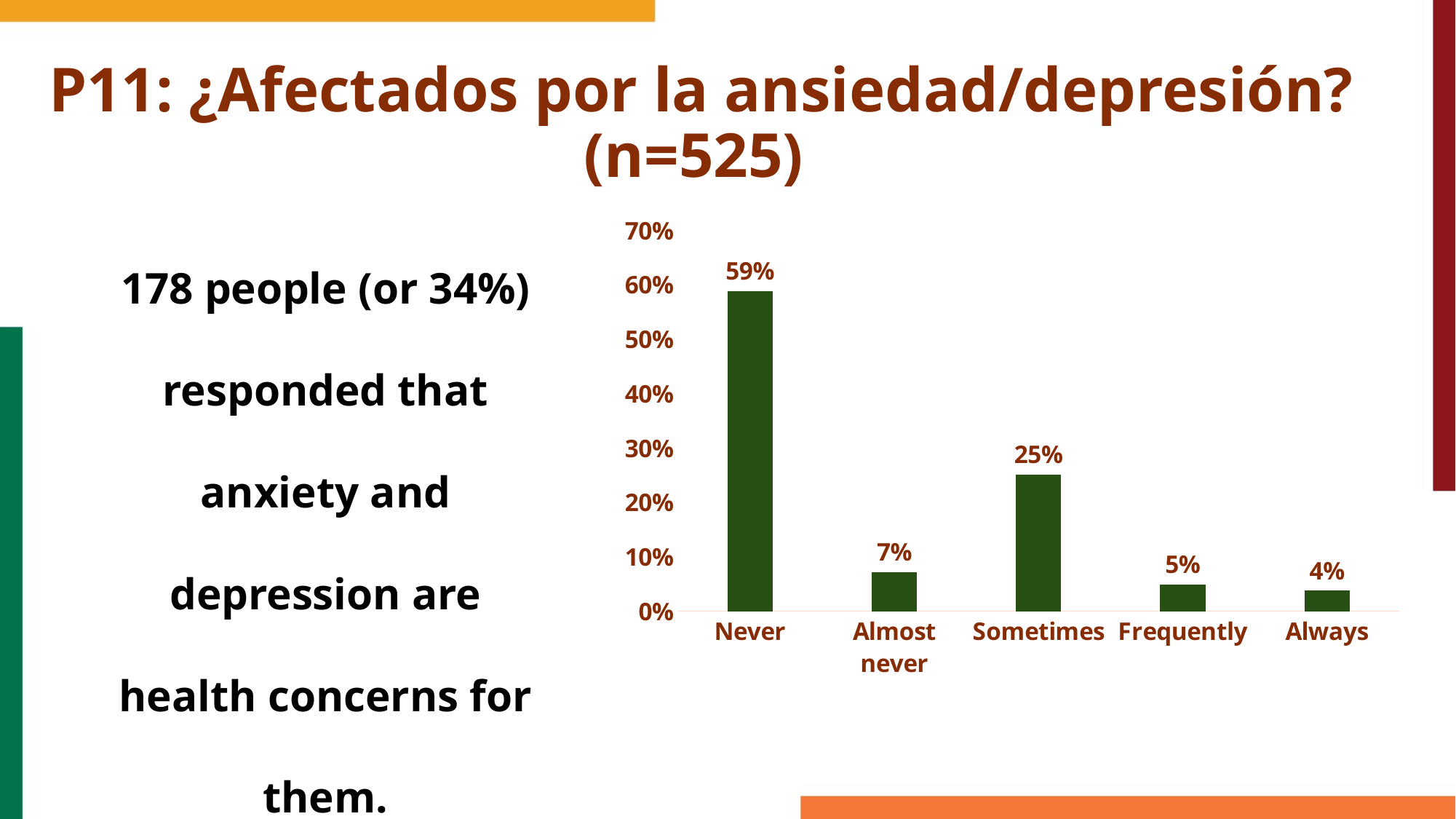
What is the value for Always? 4% What kind of chart is shown on the slide? Bar chart What is the difference between the values for Almost never and Frequently? 2% What is the value for Sometimes? 25% What is the value for Never? 59% What is the highest value shown on the y axis? 70% Which is larger, the value for Sometimes or the value for Frequently? Sometimes What is the value for Almost never? 7% How many categories are shown on the x axis? 5 What is the difference between the values for Never and Sometimes? 34% Which category has the highest value? Never Which category has the lowest value? Always